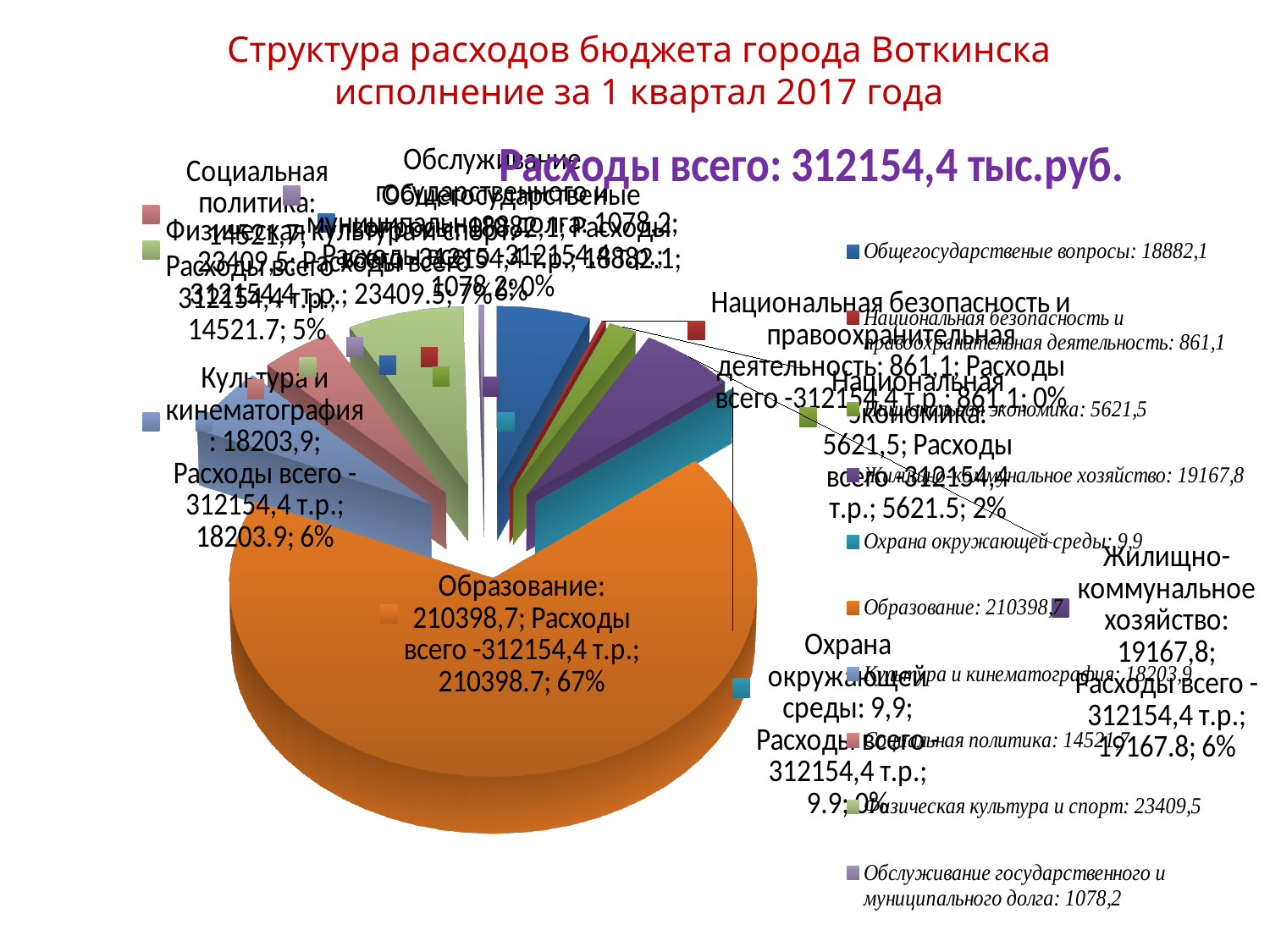
What kind of chart is shown on the slide? pie chart What is the total expenditure shown in the chart title (Расходы всего)? 312154,4 тыс.руб. Which category has the smallest value? Охрана окружающей среды Which category has the largest value? Образование What is the value for Физическая культура и спорт? 23409,5 What share of the pie does Образование represent? 67% What is the value for Обслуживание государственного и муниципального долга? 1078,2 What is the difference between Жилищно-коммунальное хозяйство and Культура и кинематография? 963,9 What is the value for Жилищно-коммунальное хозяйство? 19167,8 How many categories does the legend list? 10 What is the value for Образование? 210398,7 Which is larger, Социальная политика or Культура и кинематография? Культура и кинематография